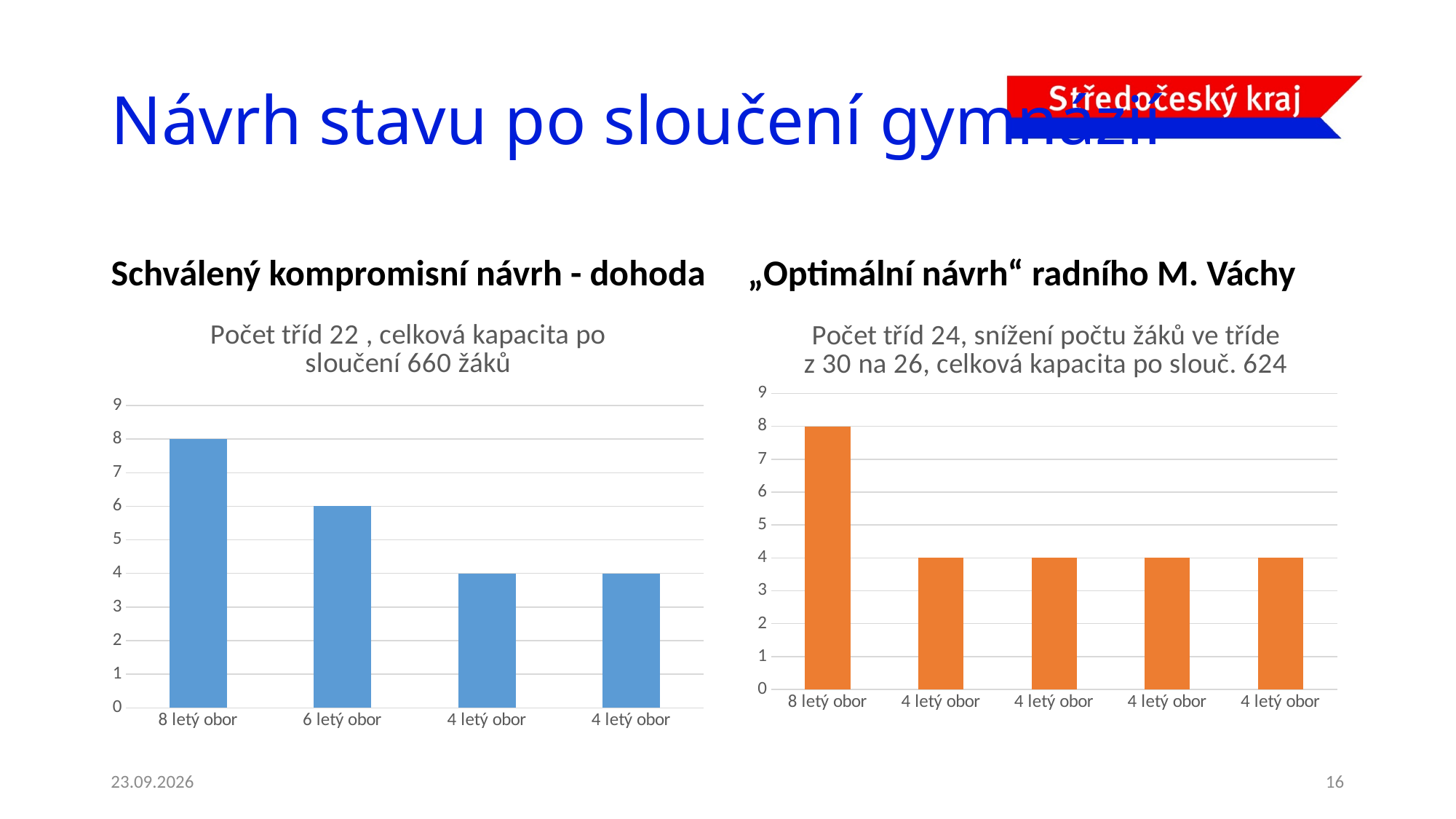
What kind of chart is the right chart (Počet tříd 24)? bar chart In the left chart (Počet tříd 22), which category has the highest value? 8 letý obor In the right chart (Počet tříd 24), what value does each of the 4 letý obor bars show? 4 In the left chart (Počet tříd 22), what is the value for 8 letý obor? 8 In the left chart (Počet tříd 22), what is the difference between the values for 8 letý obor and 6 letý obor? 2 What colour are the bars in the right chart (Počet tříd 24)? orange In the left chart (Počet tříd 22), what is the value for 6 letý obor? 6 In the right chart (Počet tříd 24), which category has the highest value? 8 letý obor In the left chart (Počet tříd 22), do the values rise or fall from left to right along the x axis? fall In the right chart (Počet tříd 24), how many bars are plotted? 5 In the right chart (Počet tříd 24), what is the value for 8 letý obor? 8 In the left chart (Počet tříd 22), how many bars are plotted? 4